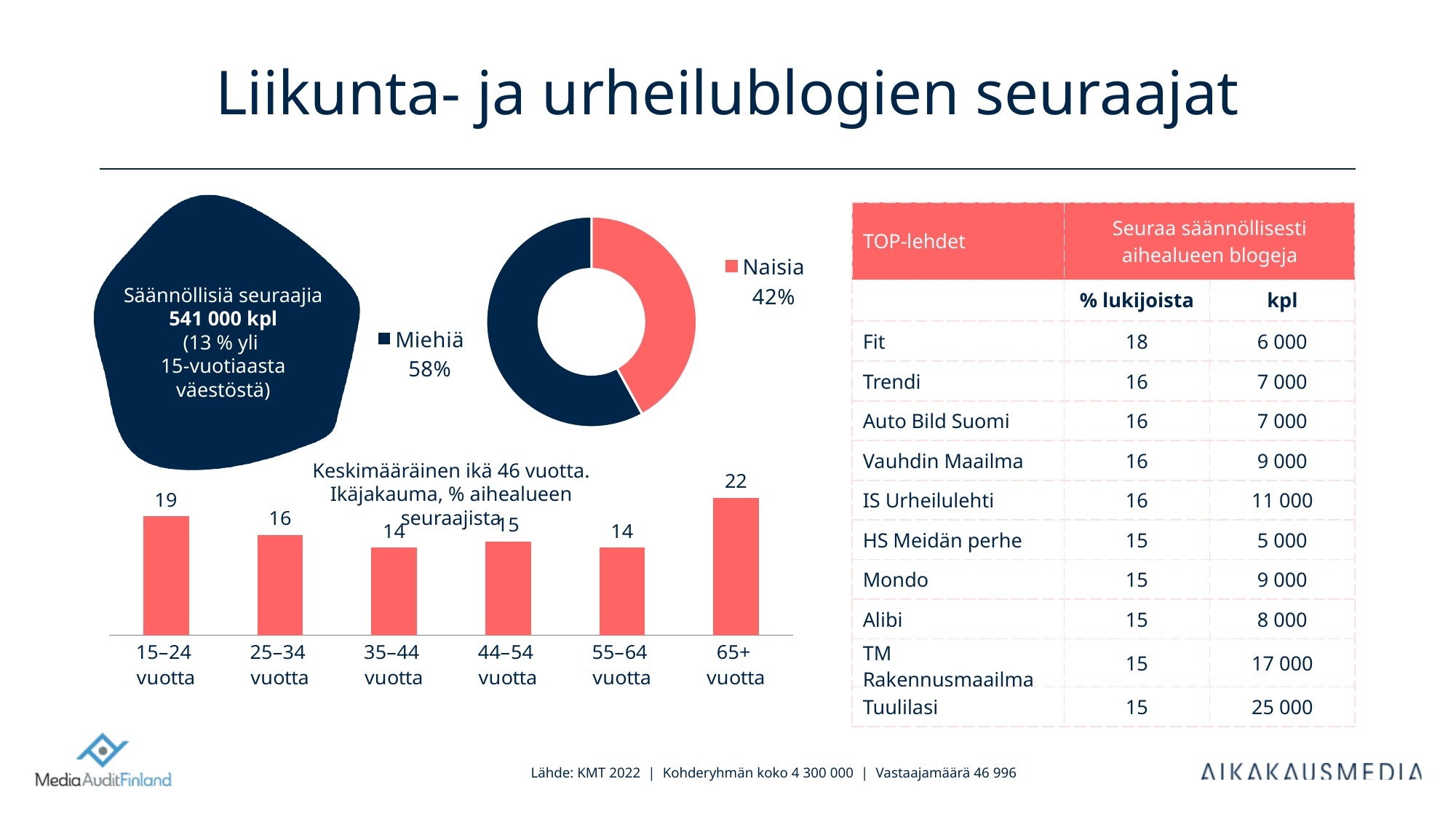
In the age distribution bar chart, which age group has the highest value? 65+ vuotta In the age distribution bar chart, which is larger, the value for 25–34 vuotta or 44–54 vuotta? 25–34 vuotta How many entries does the legend of the donut chart list? 2 In the age distribution bar chart, what is the value for 15–24 vuotta? 19 How many age groups are shown in the age distribution bar chart? 6 In the donut chart, what share is labelled Naisia? 42% In the age distribution bar chart, what is the value for 55–64 vuotta? 14 In the age distribution bar chart, what is the value for 65+ vuotta? 22 In the donut chart, what share is labelled Miehiä? 58% In the donut chart, which group has the larger share, Miehiä or Naisia? Miehiä What kind of chart is used to show the age distribution at the bottom left of the slide? Bar chart In the age distribution bar chart, what is the difference between the values for 65+ vuotta and 15–24 vuotta? 3